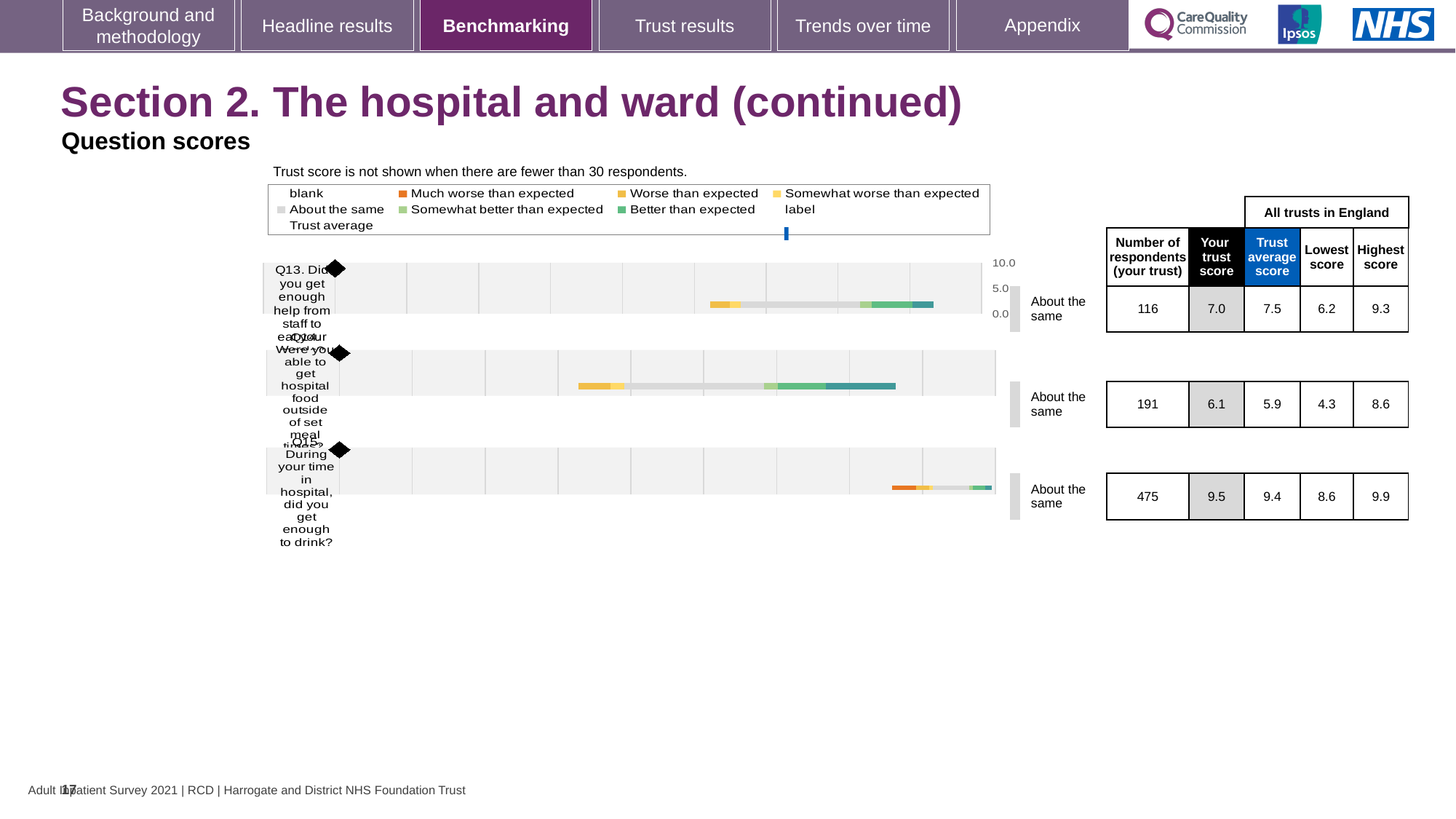
For Q14, which is larger: your trust score or the trust average score? Your trust score How many respondents answered Q15 (did you get enough to drink) at your trust? 475 What benchmark label is shown next to the Q14 bar? About the same What is the difference between the trust average score and your trust score for Q13? 0.5 What is the difference between the highest and lowest score for Q15? 1.3 What is the highest score across all trusts in England for Q13? 9.3 Which question has the highest 'Your trust score'? Q15 What is the trust average score for Q14 (Were you able to get hospital food outside of set meal times)? 5.9 Which question has the lowest number of respondents? Q13 How many questions (Q13, Q14, Q15) are plotted on the slide? 3 What is the 'Your trust score' value for Q13 (Did you get enough help from staff to eat your meals)? 7.0 What kind of chart is used to show the question scores on this slide? bar chart